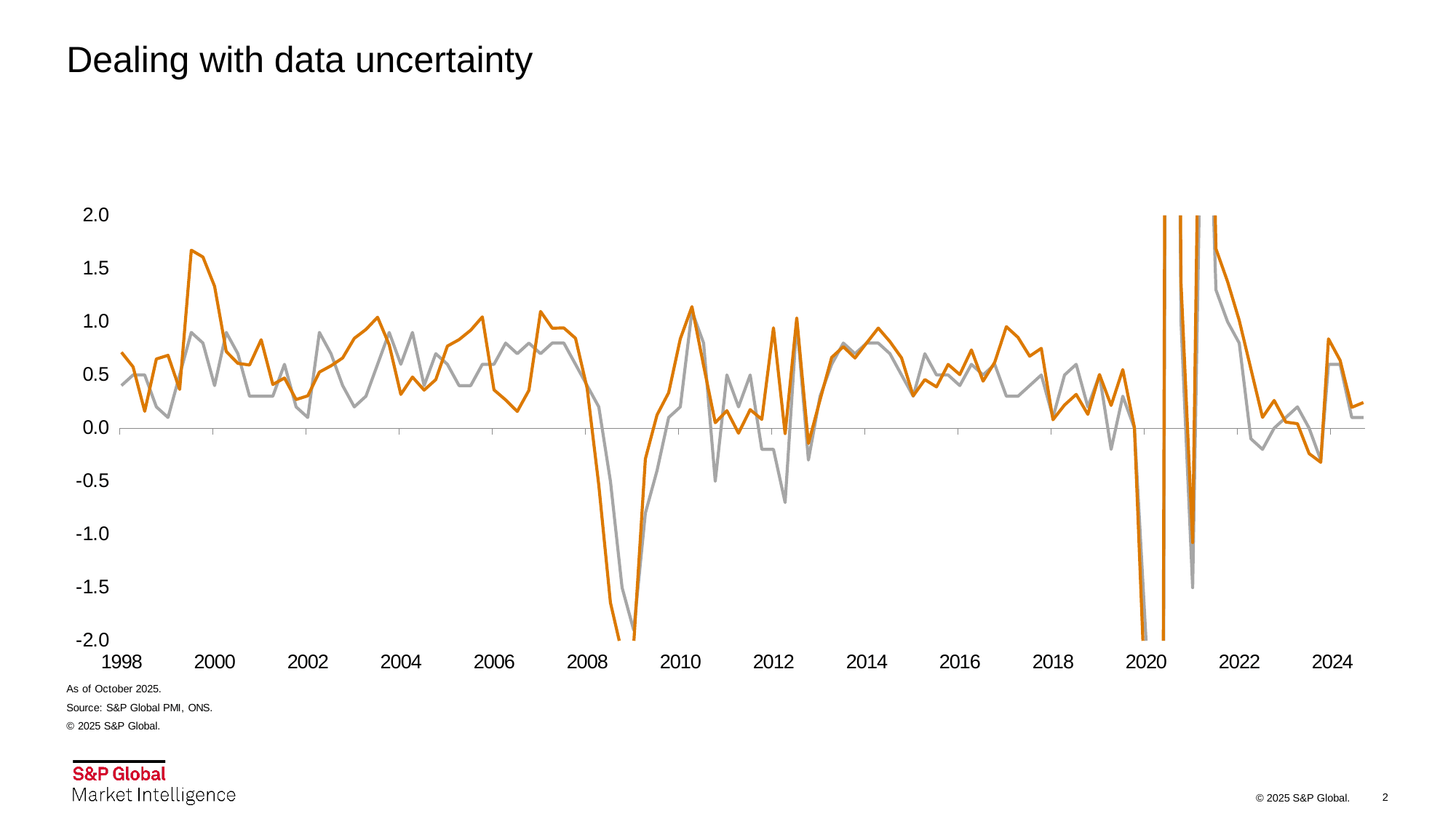
What kind of chart is shown on the slide? line chart How many lines are plotted on the chart? 2 What is the first year labelled on the x axis? 1998 Is the peak of the orange line around 2000 greater or less than 1.5? greater Is the peak of the grey line around 2000 greater or less than 1.0? less Is the lowest point of the orange line around 2009 greater or less than -1.5? less What sources are cited below the chart? S&P Global PMI, ONS How many year labels are shown on the x axis? 14 What is the last year labelled on the x axis? 2024 What colours are the two lines on the chart? orange and grey Between 2008 and 2009, do the lines rise or fall? fall What is the highest value shown on the y axis? 2.0